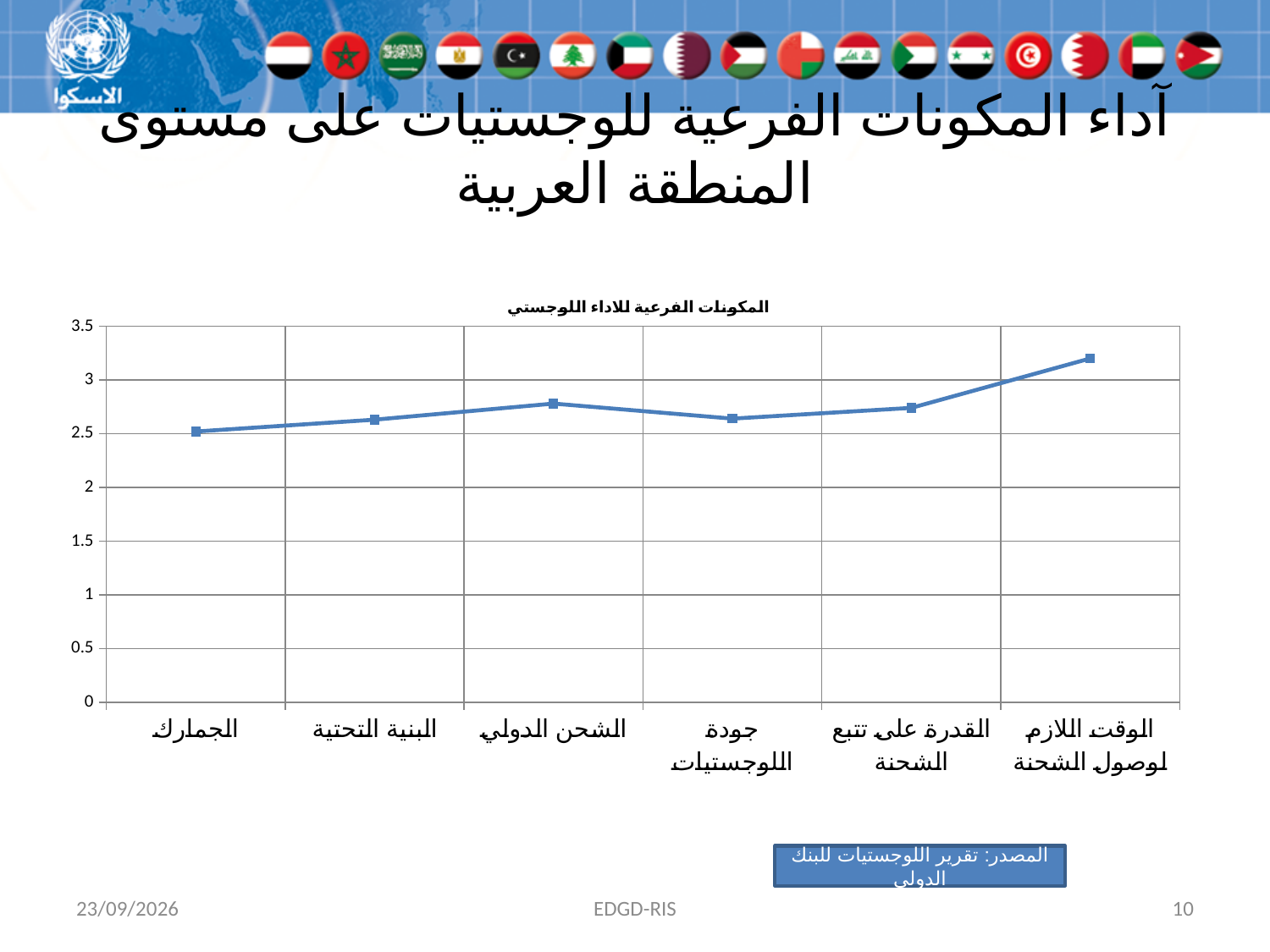
Is the value for الجمارك greater or less than 3? less Which has a larger value, الوقت اللازم لوصول الشحنة or الجمارك? الوقت اللازم لوصول الشحنة Is the value for الشحن الدولي greater or less than 2.5? greater What kind of chart is shown on the slide? Line chart Does the line rise or fall between الشحن الدولي and جودة اللوجستيات? fall Which has a larger value, الشحن الدولي or الجمارك? الشحن الدولي Does the line rise or fall between القدرة على تتبع الشحنة and الوقت اللازم لوصول الشحنة? rise Which category has the lowest value in the chart? الجمارك Is the value for الوقت اللازم لوصول الشحنة greater or less than 3? greater What is the title of the chart? المكونات الفرعية للاداء اللوجستي How many categories are plotted along the x axis of the chart? 6 Which category has the highest value in the chart? الوقت اللازم لوصول الشحنة